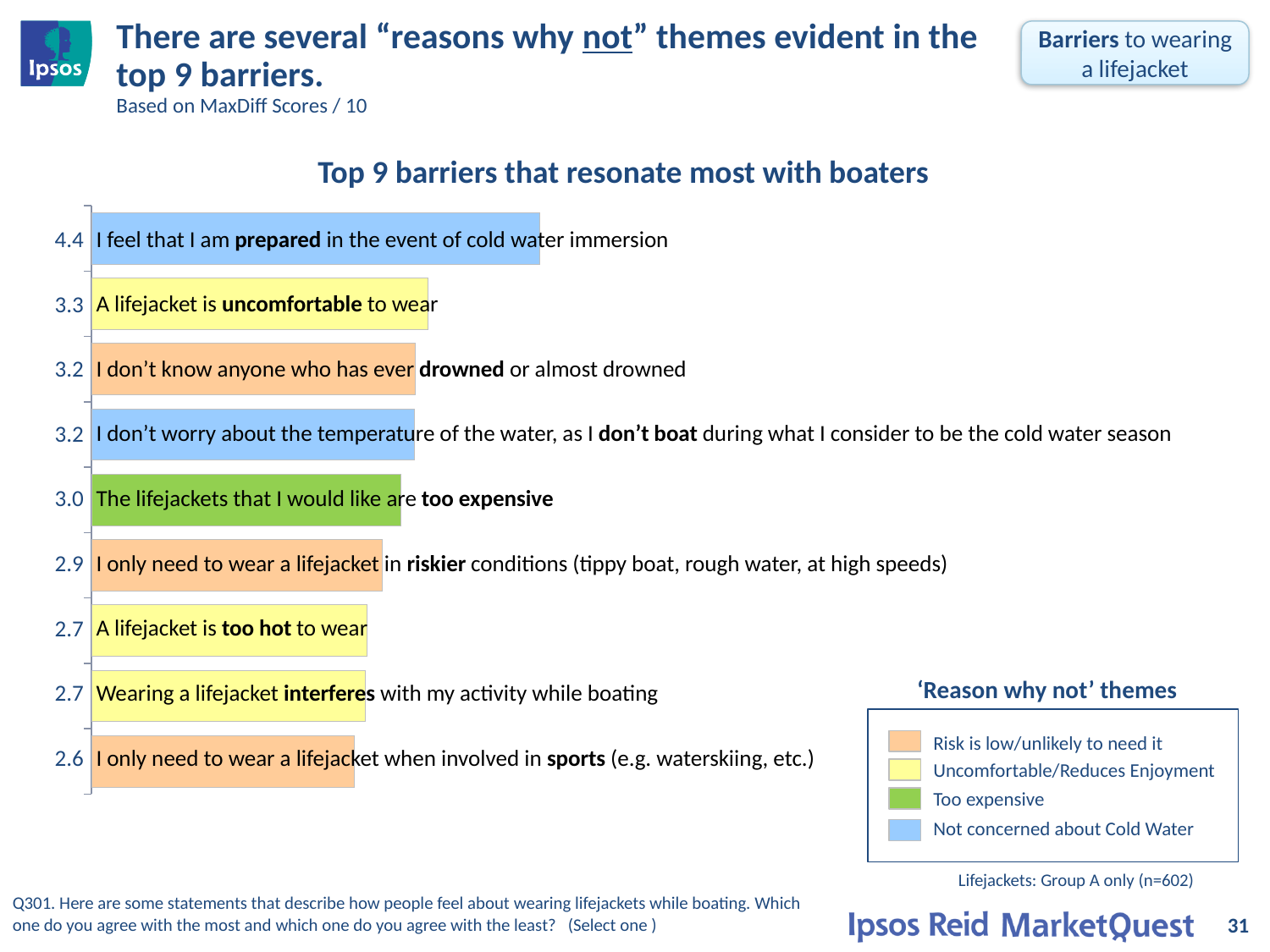
What is the score for "I only need to wear a lifejacket when involved in sports (e.g. waterskiing, etc.)"? 2.6 Which has a higher score: "The lifejackets that I would like are too expensive" or "A lifejacket is too hot to wear"? The lifejackets that I would like are too expensive Which theme does the green colour represent in the legend? Too expensive What is the difference between the score for "I feel that I am prepared in the event of cold water immersion" and the score for "A lifejacket is uncomfortable to wear"? 1.1 What is the score for "A lifejacket is uncomfortable to wear"? 3.3 How many barriers are shown in the chart? 9 Which barrier has the lowest score in the chart? I only need to wear a lifejacket when involved in sports (e.g. waterskiing, etc.) How many 'Reason why not' themes does the legend list? 4 Which barrier has the highest score in the chart? I feel that I am prepared in the event of cold water immersion What is the score for "The lifejackets that I would like are too expensive"? 3.0 What type of chart is shown on the slide? Bar chart What is the MaxDiff score for "I feel that I am prepared in the event of cold water immersion"? 4.4